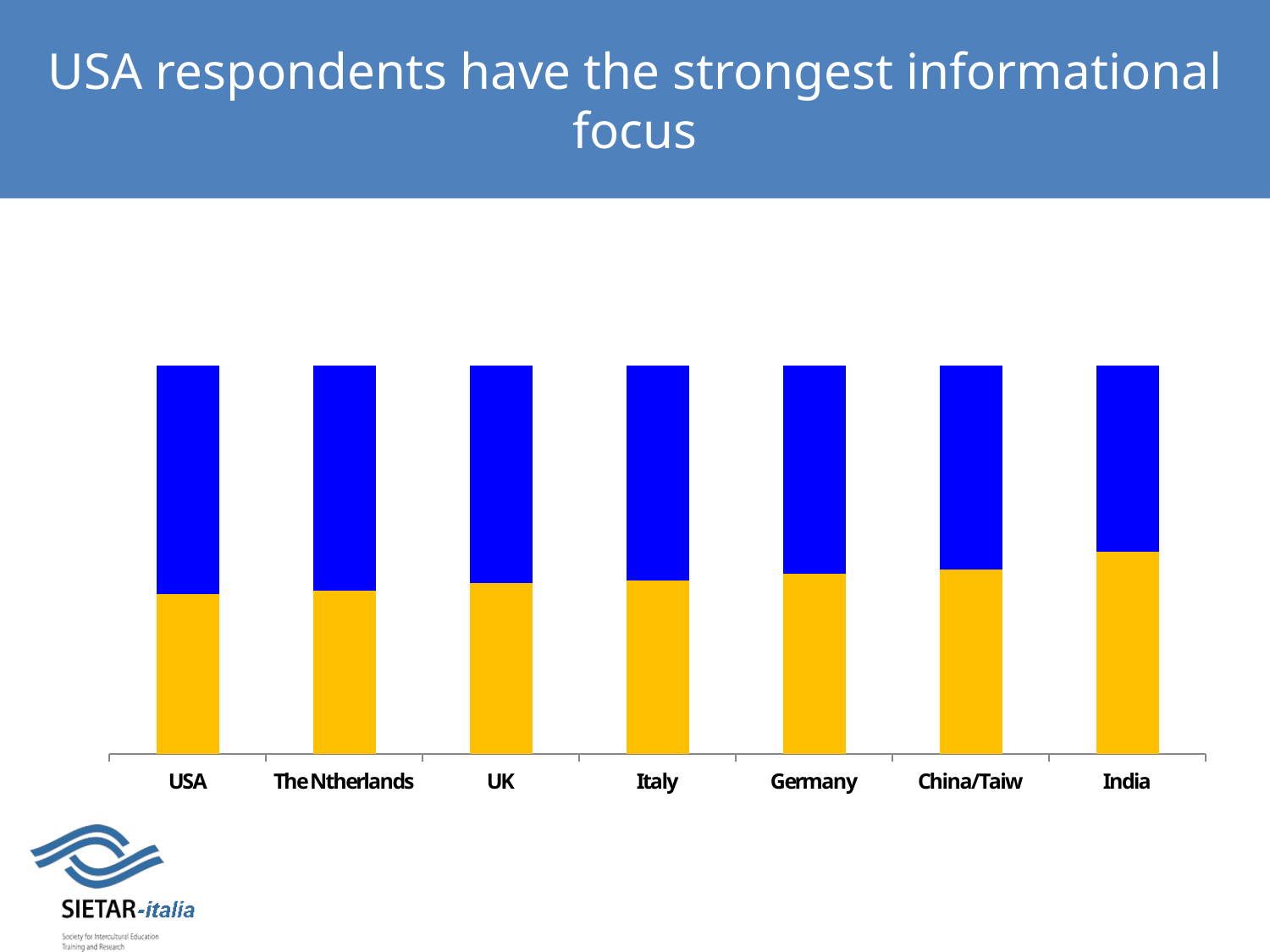
What two colours are used for the segments of each bar in the chart? Yellow and blue Moving from USA on the left to India on the right, does the yellow segment rise or fall? Rise Which category has the tallest blue segment in the chart? USA Which category has the shortest blue segment in the chart? India What is the title of the slide containing the chart? USA respondents have the strongest informational focus Which category has the shortest yellow segment in the chart? USA What kind of chart is shown on the slide? Stacked bar chart Is the blue segment larger for USA or for Germany? USA Moving from USA on the left to India on the right, does the blue segment rise or fall? Fall Is the yellow segment larger for India or for USA? India Which category has the tallest yellow segment in the chart? India How many countries or regions are shown on the x axis of the chart? 7